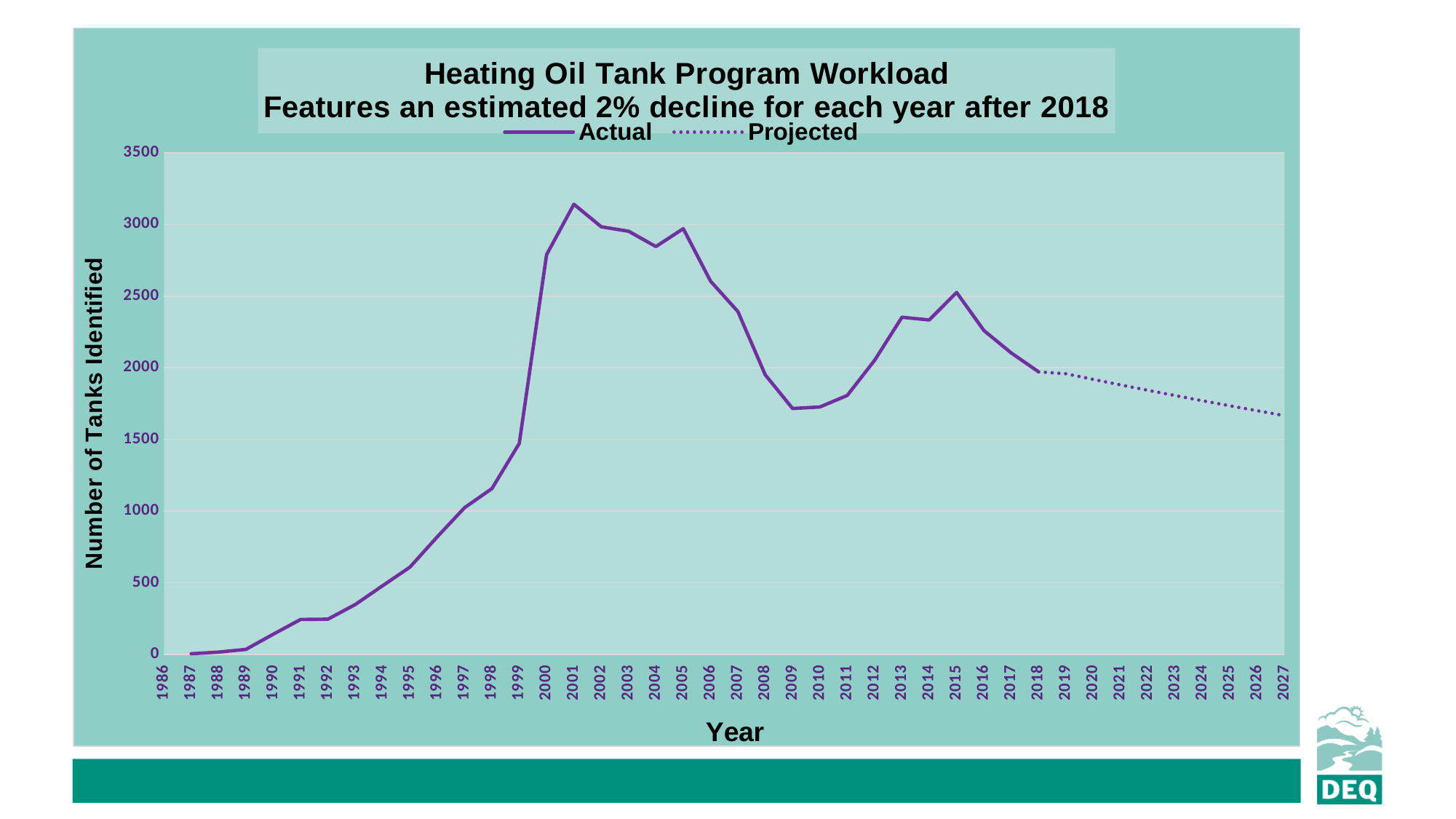
In which year is the Actual series at its lowest value? 1987 What is the label of the y axis? Number of Tanks Identified Is the Actual value for 2009 greater or less than 2000? less How many series does the legend list? 2 Which year has the larger Actual value, 2009 or 2013? 2013 Is the Actual value for 2005 greater or less than 2500? greater Does the Projected series rise or fall from 2019 to 2027? fall In which year does the Actual series reach its highest value? 2001 What are the two series named in the legend? Actual and Projected What kind of chart is shown on the slide? line chart Is the Projected value for 2027 greater or less than 2000? less